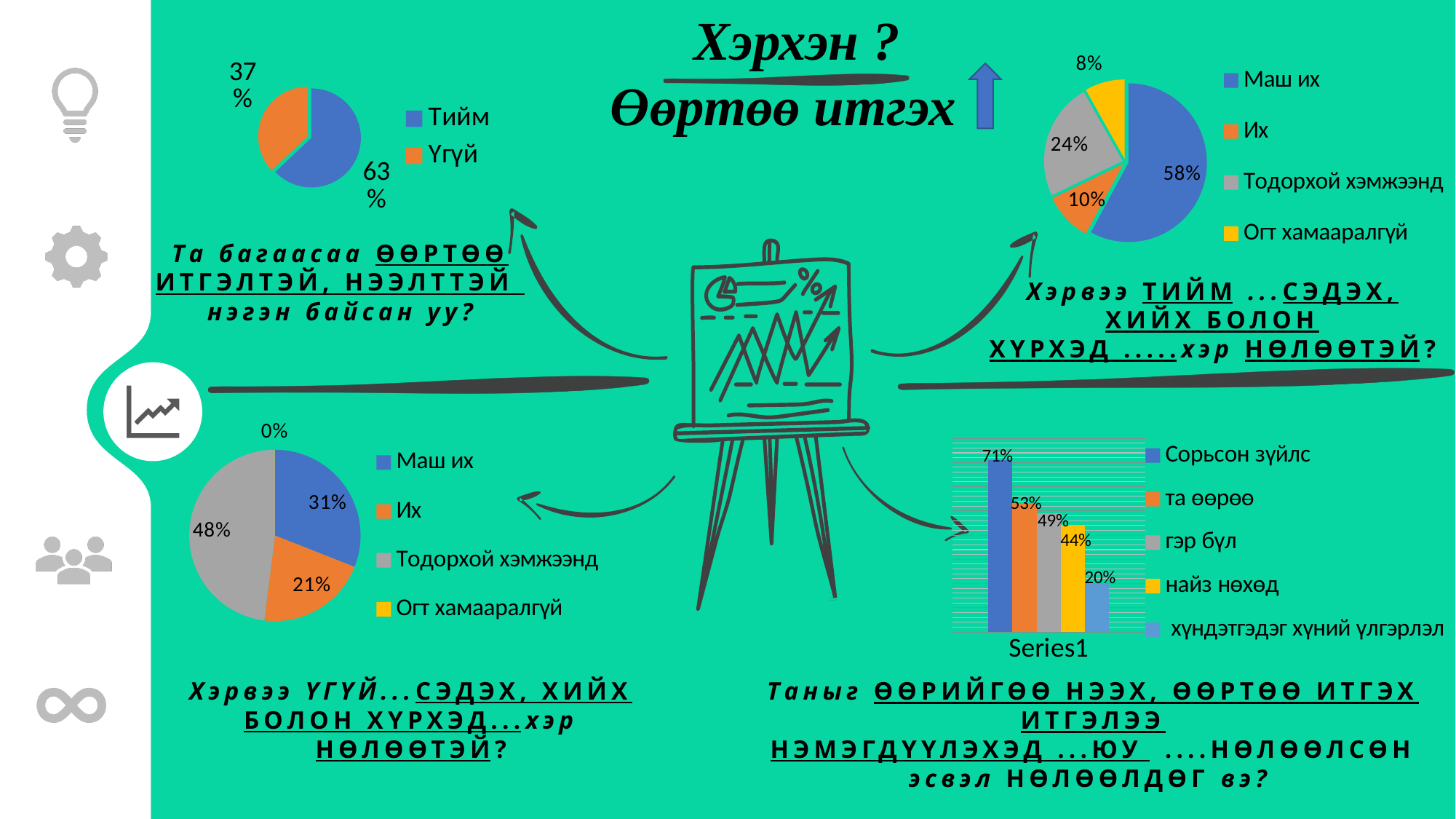
In the top-left pie chart, what percentage is shown for Тийм? 63% In the bottom-right bar chart, what is the difference between the values for гэр бүл and найз нөхөд? 5% In the bottom-left pie chart, which is larger, Маш их or Их? Маш их In the top-left pie chart, what is the difference between the Тийм and Үгүй shares? 26% In the bottom-right bar chart, which category has the highest value? Сорьсон зүйлс In the top-right pie chart, how many categories does the legend list? 4 What kind of chart is the bottom-right chart? Bar chart In the top-left pie chart, what percentage is shown for Үгүй? 37% In the top-right pie chart, what percentage is shown for Маш их? 58% In the bottom-left pie chart, what percentage is shown for Тодорхой хэмжээнд? 48% In the top-right pie chart, which category has the smallest share? Огт хамааралгүй In the bottom-left pie chart, what percentage is shown for Огт хамааралгүй? 0%